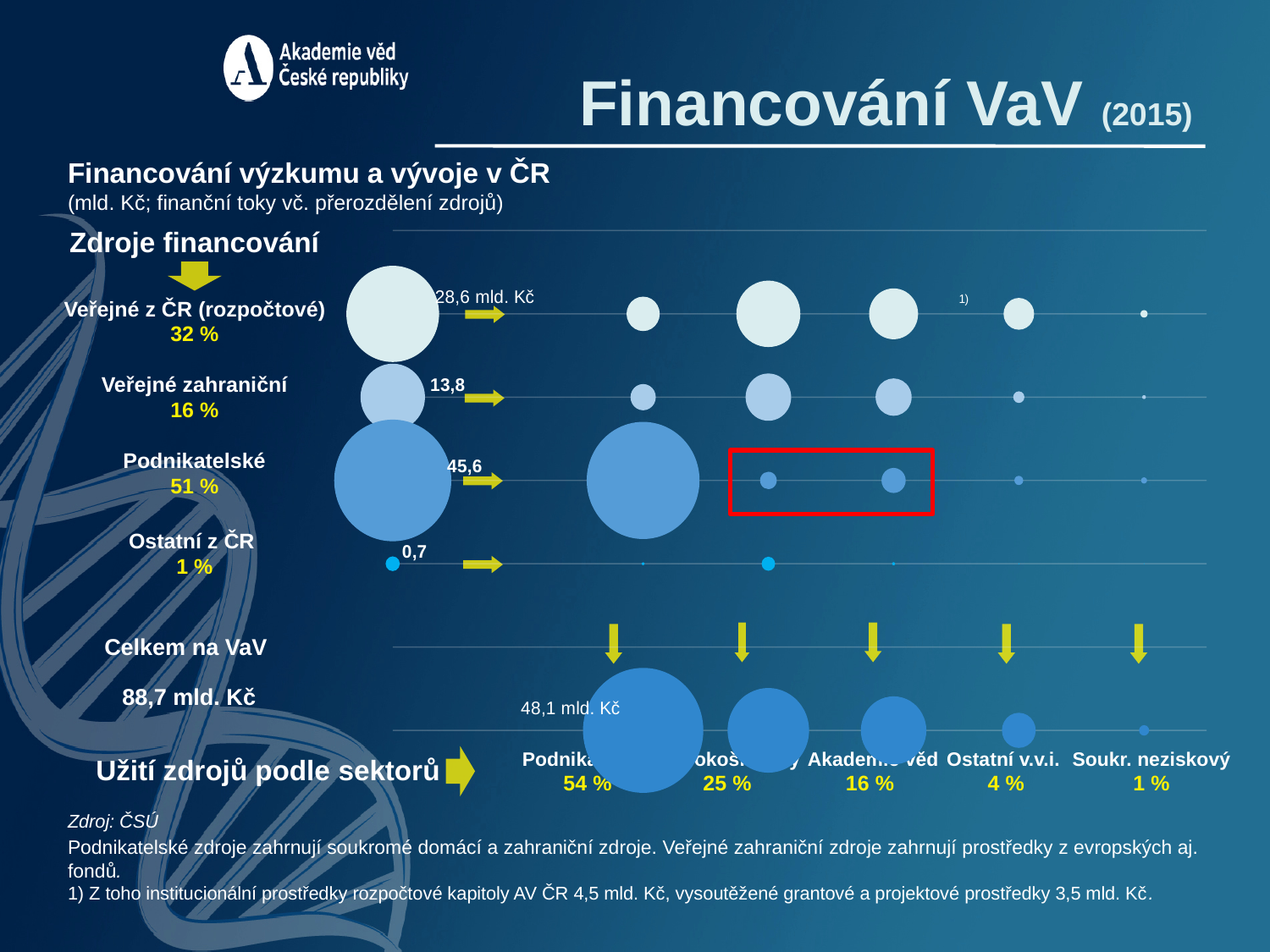
What is the difference in mld. Kč between the Podnikatelské source (45,6) and the Veřejné z ČR (rozpočtové) source (28,6)? 17,0 What percentage share do Podnikatelské sources have in the financing of R&D? 51 % What kind of chart is used to show the financial flows on this slide? Bubble chart Which source of financing is the largest? Podnikatelské What is the value for Veřejné z ČR (rozpočtové) among the sources of financing? 28,6 mld. Kč What is the value shown for Ostatní z ČR sources? 0,7 What is the value shown for Veřejné zahraniční sources? 13,8 Which source of financing is the smallest? Ostatní z ČR What is the total amount spent on R&D (Celkem na VaV)? 88,7 mld. Kč How many sources of financing are listed on the left side of the chart? 4 What share of the use of resources by sector goes to Akademie věd? 16 % What share of the use of resources by sector goes to Ostatní v.v.i.? 4 %